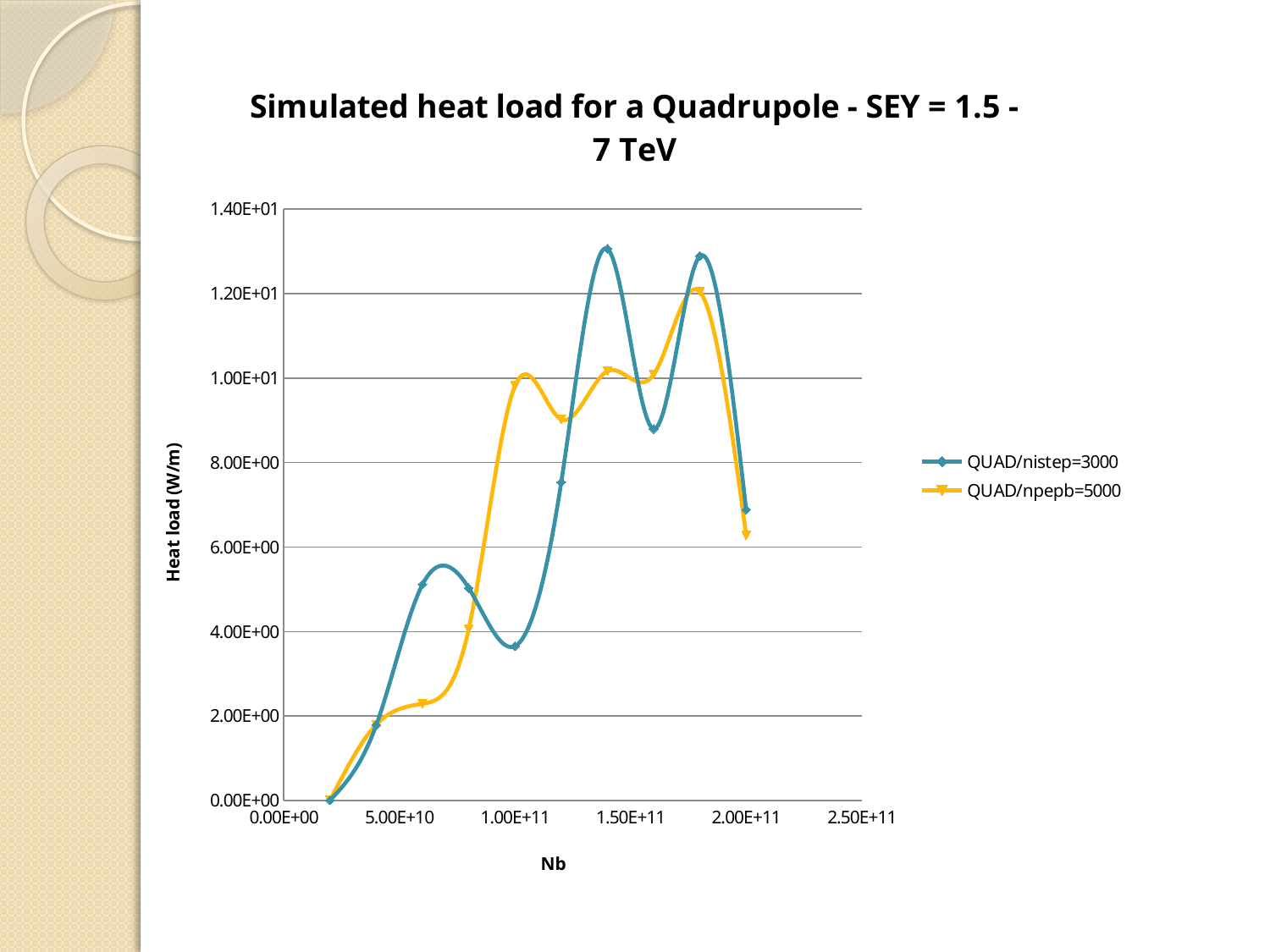
How many data points does the QUAD/nistep=3000 series have? 10 Is the value of QUAD/npepb=5000 at Nb = 6.00E+10 greater or less than 4.00E+00? less Is the value of QUAD/nistep=3000 at Nb = 1.20E+11 greater or less than 8.00E+00? less Is the value of QUAD/npepb=5000 at Nb = 1.80E+11 greater or less than 1.00E+01? greater What are the two series named in the legend? QUAD/nistep=3000 and QUAD/npepb=5000 What is the label of the y axis? Heat load (W/m) At Nb = 1.00E+11, which series has the higher heat load? QUAD/npepb=5000 At Nb = 1.40E+11, which series has the higher heat load? QUAD/nistep=3000 What kind of chart is shown on the slide? Line chart How many series does the legend list? 2 At which Nb value does the QUAD/npepb=5000 series reach its highest heat load? 1.80E+11